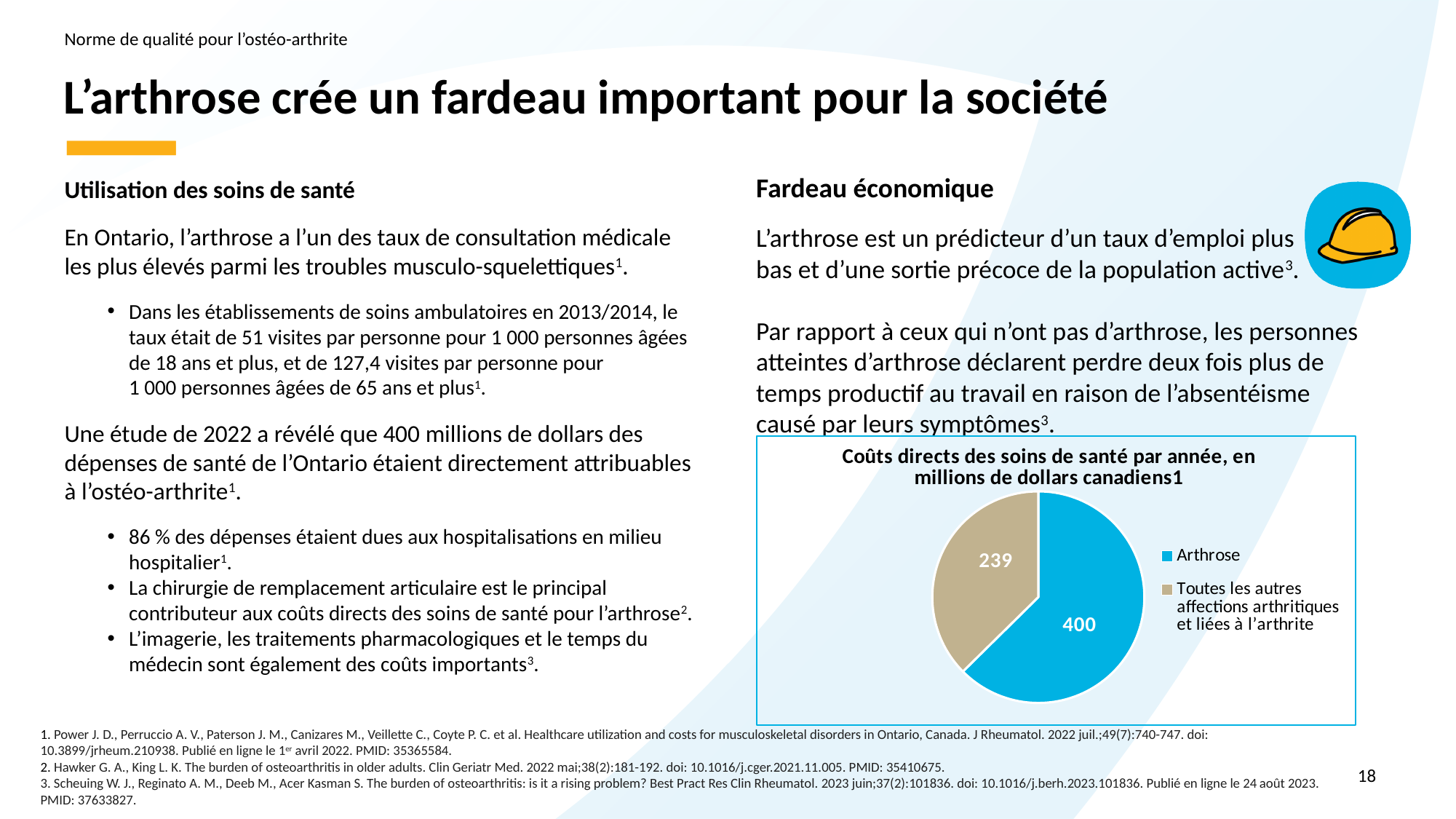
What colour is the Arthrose slice in the pie chart? Blue What kind of chart is shown on the slide? Pie chart What is the total of the two values shown in the pie chart? 639 Which is larger: the value for Arthrose or the value for all other arthritic and arthritis-related conditions? Arthrose How many slices does the pie chart have? 2 What is the title of the pie chart? Coûts directs des soins de santé par année, en millions de dollars canadiens1 Which slice of the pie chart is the largest? Arthrose What is the difference between the Arthrose value and the value for all other arthritic and arthritis-related conditions? 161 Which slice of the pie chart is the smallest? Toutes les autres affections arthritiques et liées à l'arthrite What is the value for "Toutes les autres affections arthritiques et liées à l'arthrite" in the pie chart? 239 How many entries does the legend of the pie chart list? 2 What is the value for Arthrose in the pie chart? 400